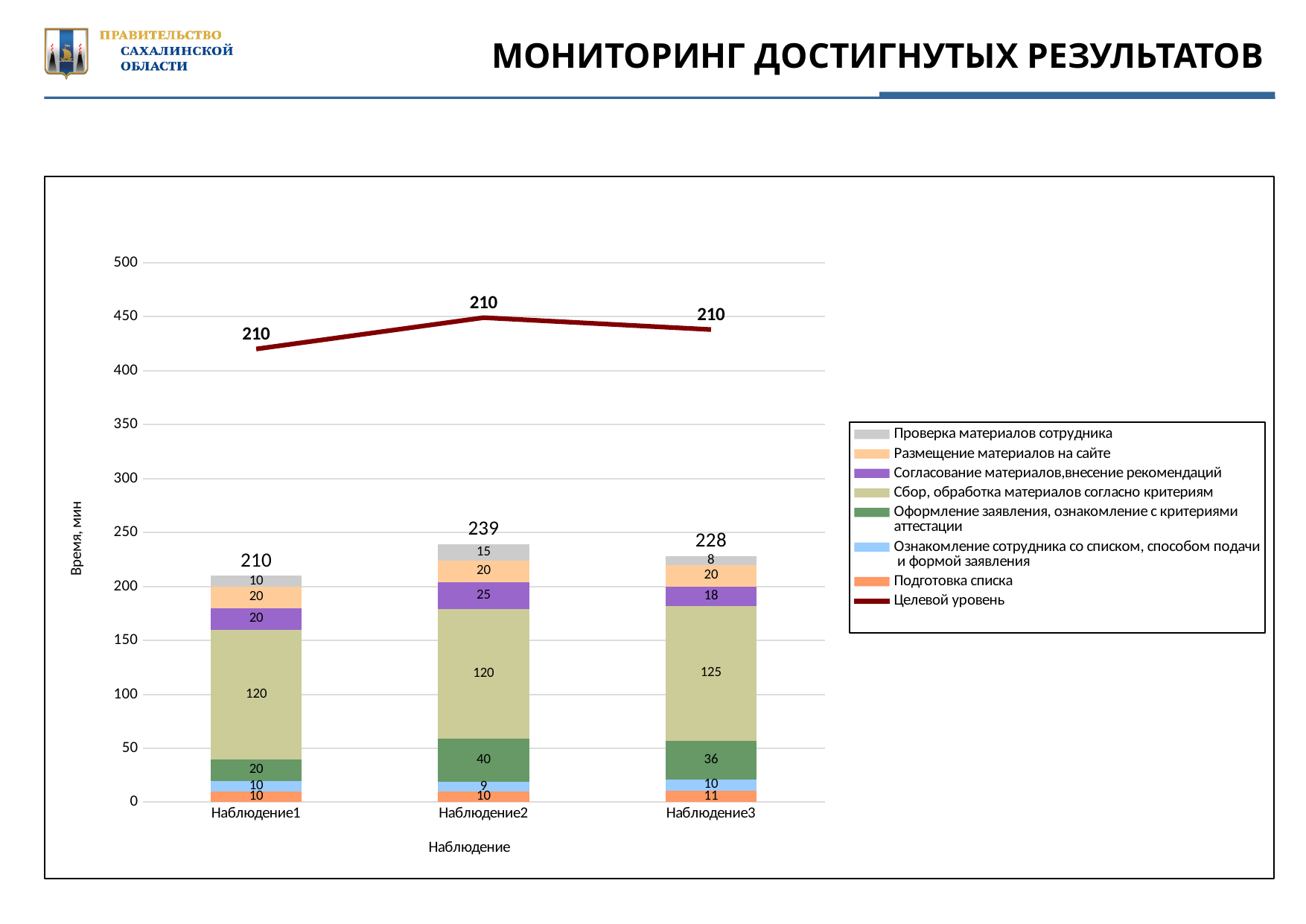
Which observation has the lowest stacked bar total? Наблюдение1 What is the value of Целевой уровень for Наблюдение1? 210 What is the label of the y axis? Время, мин What is the total of the stacked bar for Наблюдение2? 239 What is the difference between the stacked bar totals for Наблюдение2 and Наблюдение3? 11 Which observation has the highest stacked bar total? Наблюдение2 How many observations (categories) are shown on the x axis? 3 Which is larger: Согласование материалов,внесение рекомендаций for Наблюдение2 or for Наблюдение3? Наблюдение2 What is the value of Проверка материалов сотрудника for Наблюдение3? 8 How many series does the legend list? 8 What is the value of Сбор, обработка материалов согласно критериям for Наблюдение3? 125 What is the value of Оформление заявления, ознакомление с критериями аттестации for Наблюдение2? 40